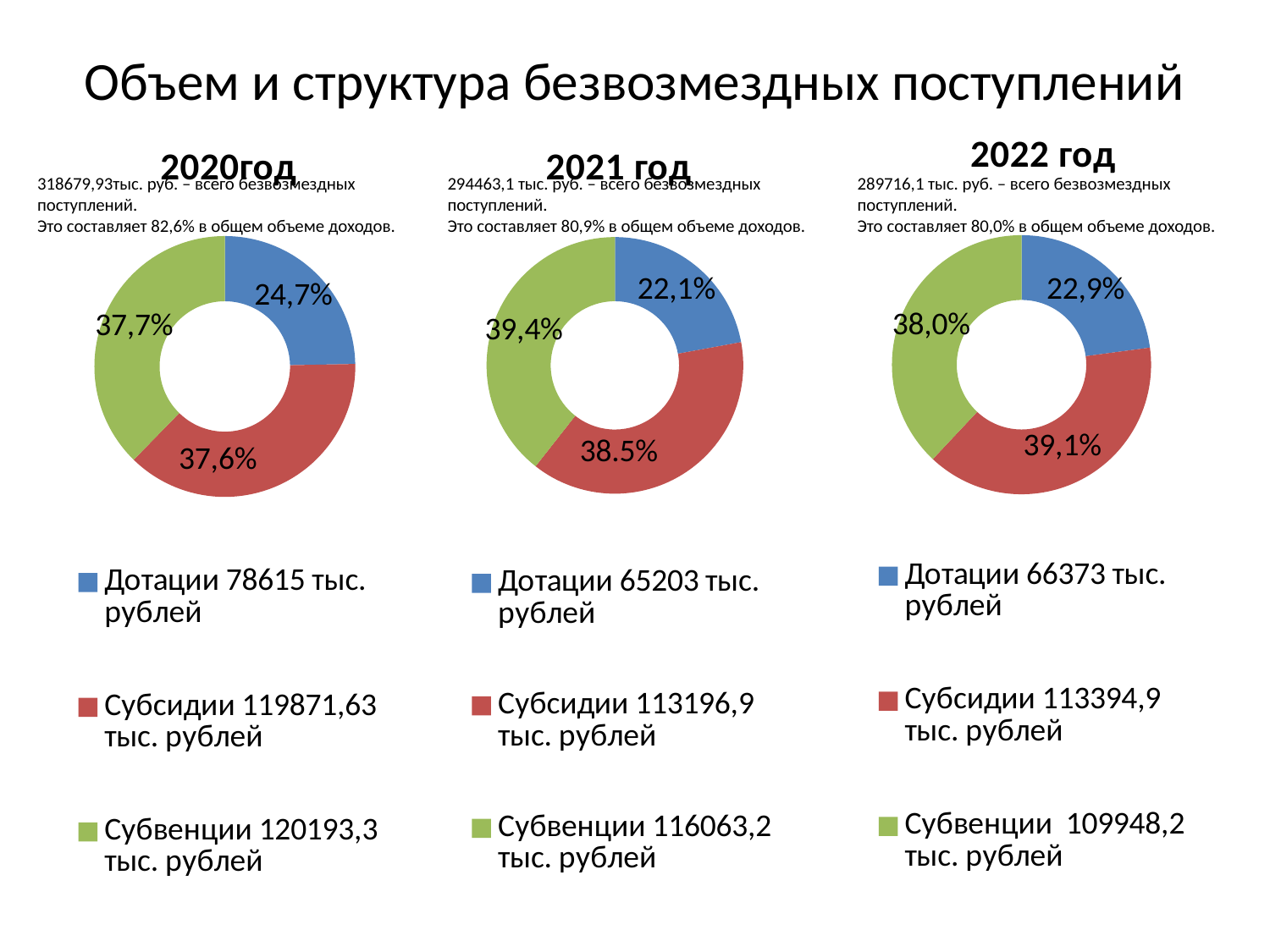
In the 2020 год chart, which is larger: the share of Дотации or the share of Субсидии? Субсидии What colour represents Субвенции in the 2020 год chart? green What type of chart is used for the 2020 год chart? pie chart (donut) In the 2021 год chart, which category has the smallest share? Дотации In the 2021 год chart, what share of the total is Субсидии? 38.5% In the 2020 год chart, what share of the total is Дотации? 24,7% In the 2022 год chart, which category has the largest share? Субсидии How many categories are shown in the 2022 год chart? 3 In the 2022 год chart, what share of the total is Дотации? 22,9% According to the legend of the 2022 год chart, what is the value of Дотации? 66373 тыс. рублей According to the legend of the 2021 год chart, what is the value of Субвенции? 116063,2 тыс. рублей